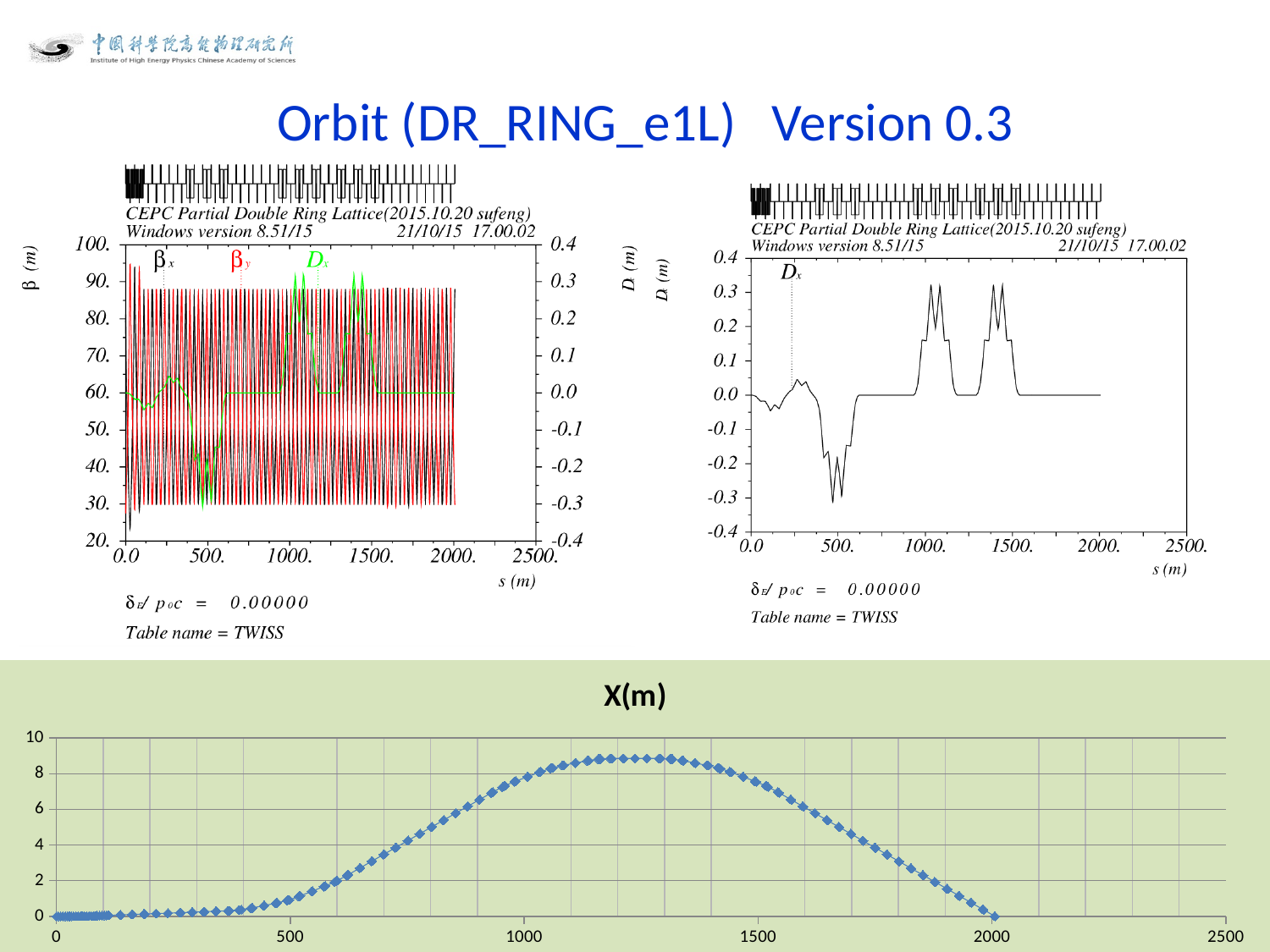
In the top-right chart, is the maximum value of Dx greater or less than 0.2? greater In the bottom chart titled X(m), is the value at x = 1500 greater or less than 6? greater In the bottom chart titled X(m), do the values rise or fall between x = 1500 and x = 2000? fall In the top-left chart, how many series are labelled in the legend? 3 In the top-left chart, what colour is the βy curve? red What kind of chart is the bottom chart titled X(m)? line chart with markers In the bottom chart titled X(m), what is the highest value shown on the vertical axis? 10 In the bottom chart titled X(m), is the peak value greater or less than 8? greater In the bottom chart titled X(m), do the values rise or fall between x = 500 and x = 1200? rise